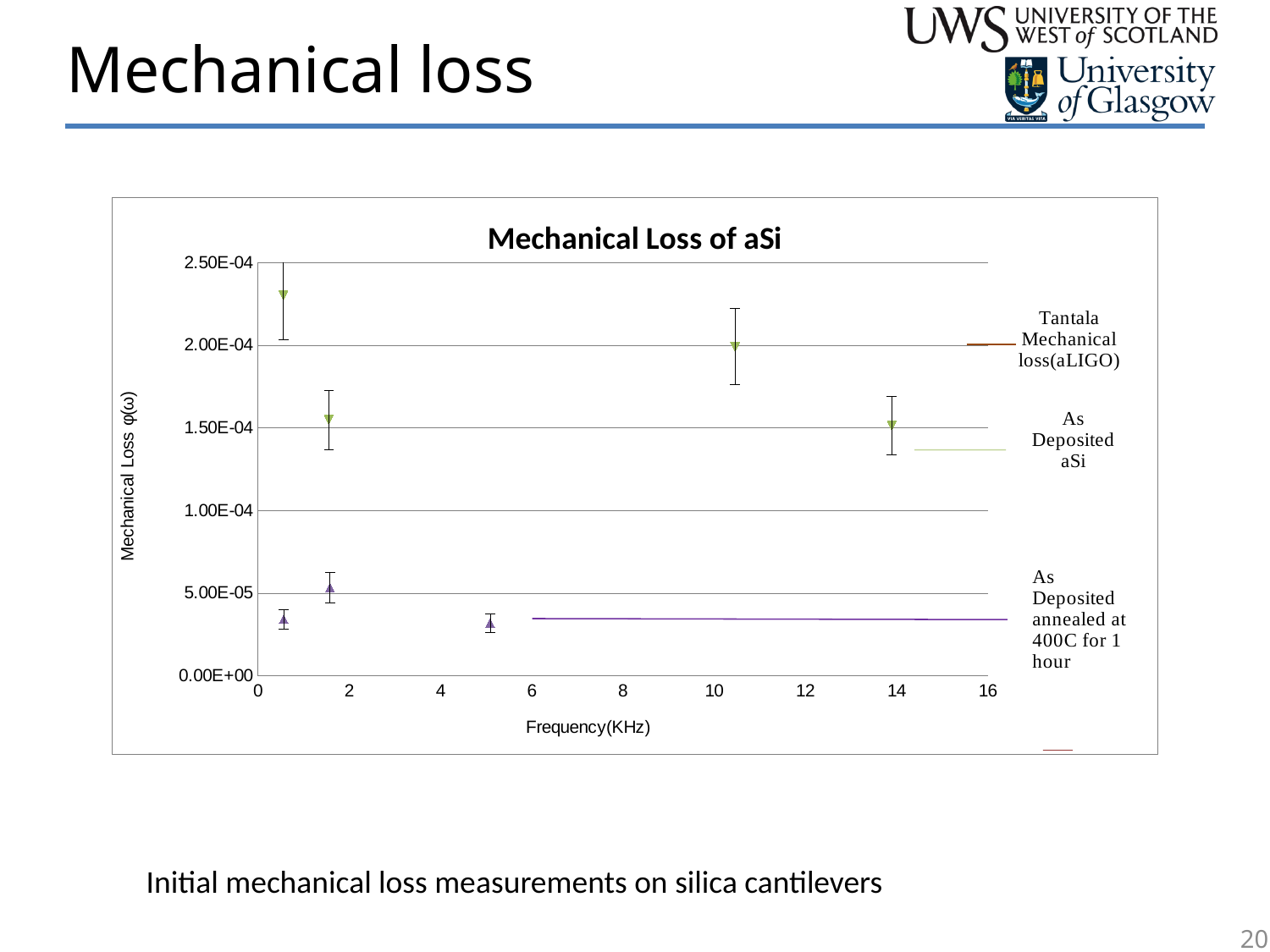
Which series has the highest plotted mechanical loss value on the chart? As Deposited aSi How many data points are plotted for the As Deposited aSi series? 4 What is the title of the chart? Mechanical Loss of aSi Is the mechanical loss of the As Deposited annealed at 400C for 1 hour point near 1.5 kHz greater or less than 1.00E-04? less What is the label of the x axis of the chart? Frequency(KHz) How many data points are plotted for the As Deposited annealed at 400C for 1 hour series? 3 Is the mechanical loss of the As Deposited aSi point near 1.5 kHz greater or less than 1.00E-04? greater Is the mechanical loss of the As Deposited aSi point at the lowest frequency (near 0.5 kHz) greater or less than 2.00E-04? greater What kind of chart is shown on the slide? scatter chart Which series has the lowest plotted mechanical loss values on the chart? As Deposited annealed at 400C for 1 hour Near 1.5 kHz, which series has the larger mechanical loss: As Deposited aSi or As Deposited annealed at 400C for 1 hour? As Deposited aSi